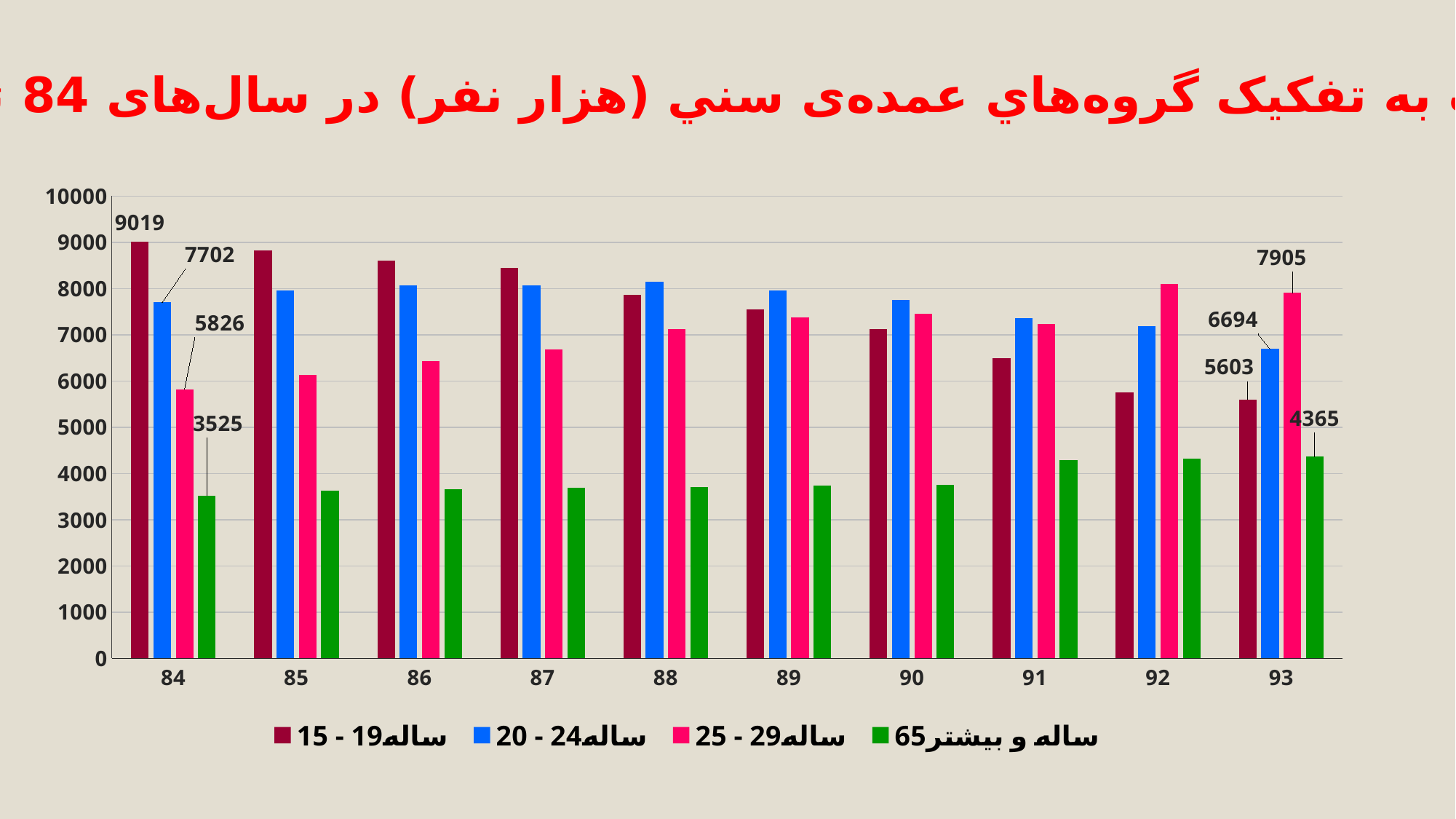
In year 84, which series has the highest value? 15 - 19 ساله What is the difference between the 15 - 19 ساله value in year 84 and in year 93? 3416 What is the difference between the 65 ساله و بیشتر value in year 93 and in year 84? 840 What is the value for the 65 ساله و بیشتر series in year 93? 4365 Does the 15 - 19 ساله series rise or fall from year 84 to year 93? fall What kind of chart is shown on the slide? bar chart Is the value for the 25 - 29 ساله series in year 88 greater or less than 6000? greater What is the value for the 15 - 19 ساله series in year 84? 9019 In year 93, which series has the lowest value? 65 ساله و بیشتر How many series does the legend list? 4 What is the value for the 25 - 29 ساله series in year 93? 7905 What is the value for the 20 - 24 ساله series in year 84? 7702